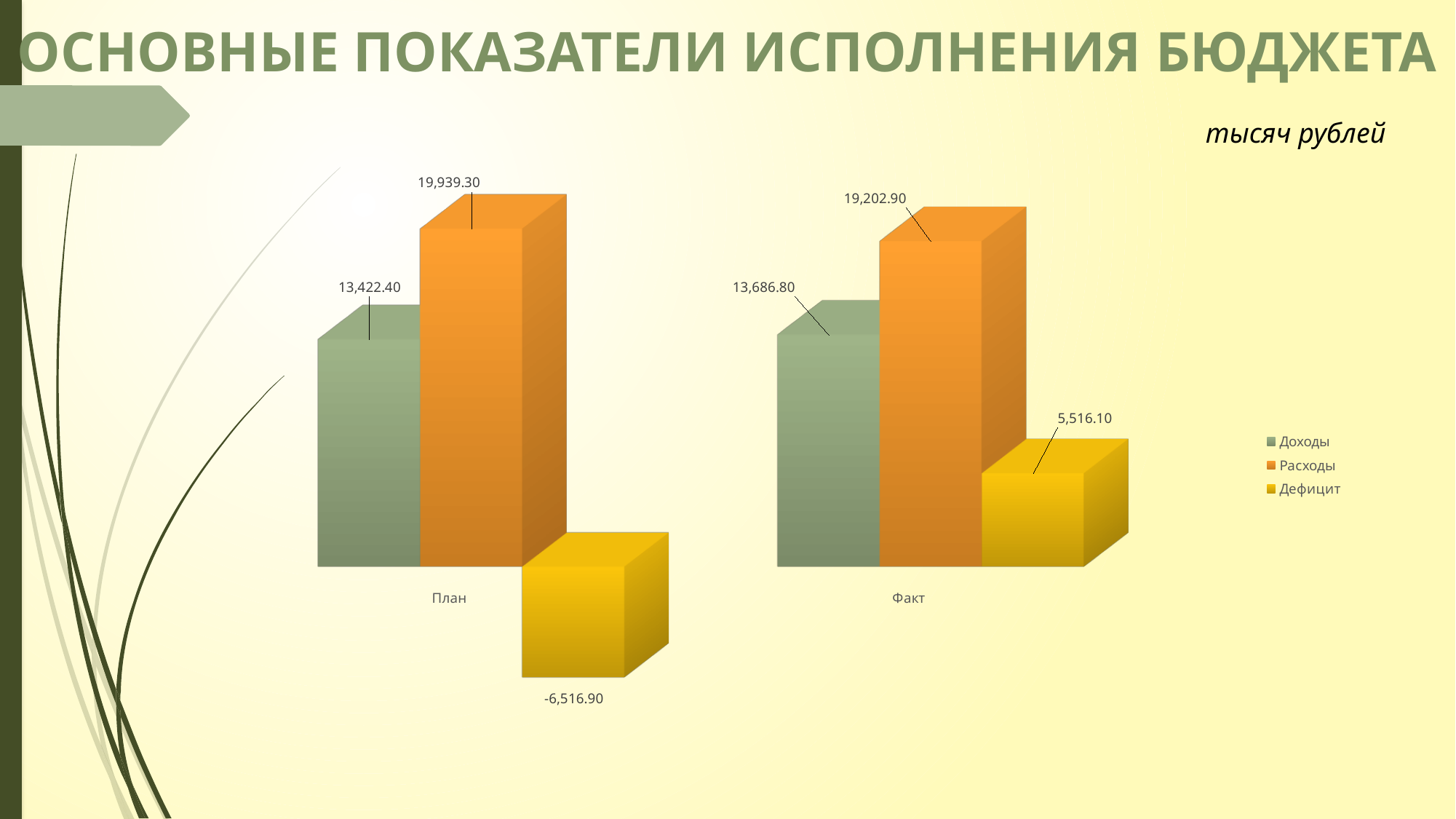
What is the value of Расходы for План? 19,939.30 What is the difference between Расходы for План and Расходы for Факт? 736.40 Which series has the lowest value for План? Дефицит What is the value of Дефицит for Факт? 5,516.10 What is the difference between Доходы for Факт and Доходы for План? 264.40 Which series has the highest value for Факт? Расходы What kind of chart is shown on the slide? Bar chart How many series does the legend list? 3 Which is larger: Доходы for План or Доходы for Факт? Доходы for Факт What is the value of Дефицит for План? -6,516.90 How many categories are shown on the x axis? 2 What is the value of Доходы for Факт? 13,686.80